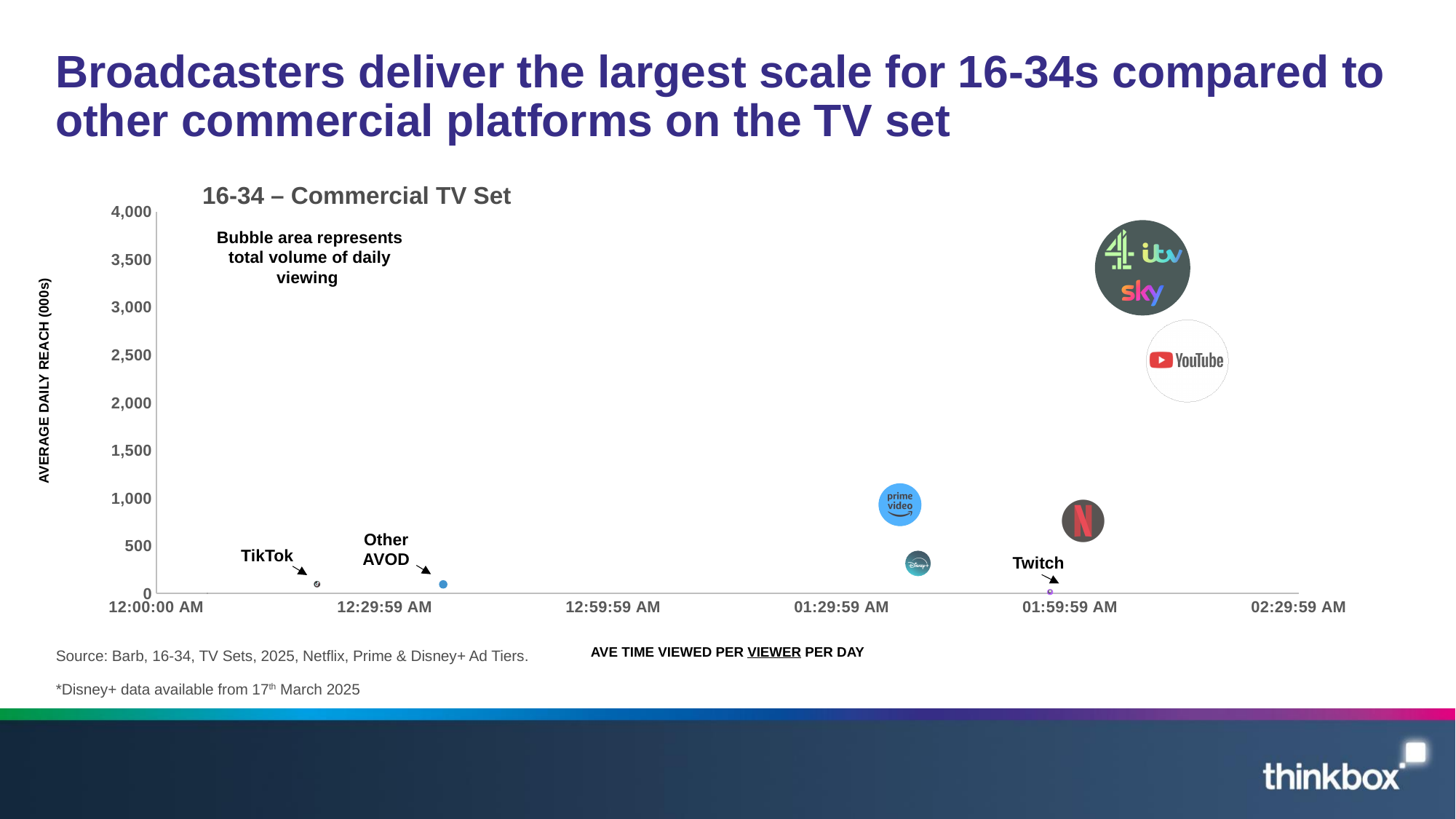
Is the average daily reach for TikTok greater or less than 500? less Is the average daily reach for Disney+ greater or less than 500? less Which has a higher average daily reach, Netflix or Disney+? Netflix What does the bubble area represent in the chart? Total volume of daily viewing What kind of chart is shown on the slide? Bubble chart Is the average daily reach for the broadcasters bubble (4, ITV, Sky) greater or less than 3,000? greater How many platform bubbles are plotted in the chart? 8 Which platform has the highest average daily reach in the chart? Broadcasters (4, ITV, Sky) Which platform has the lowest average daily reach in the chart? Twitch What is the title of the chart? 16-34 – Commercial TV Set